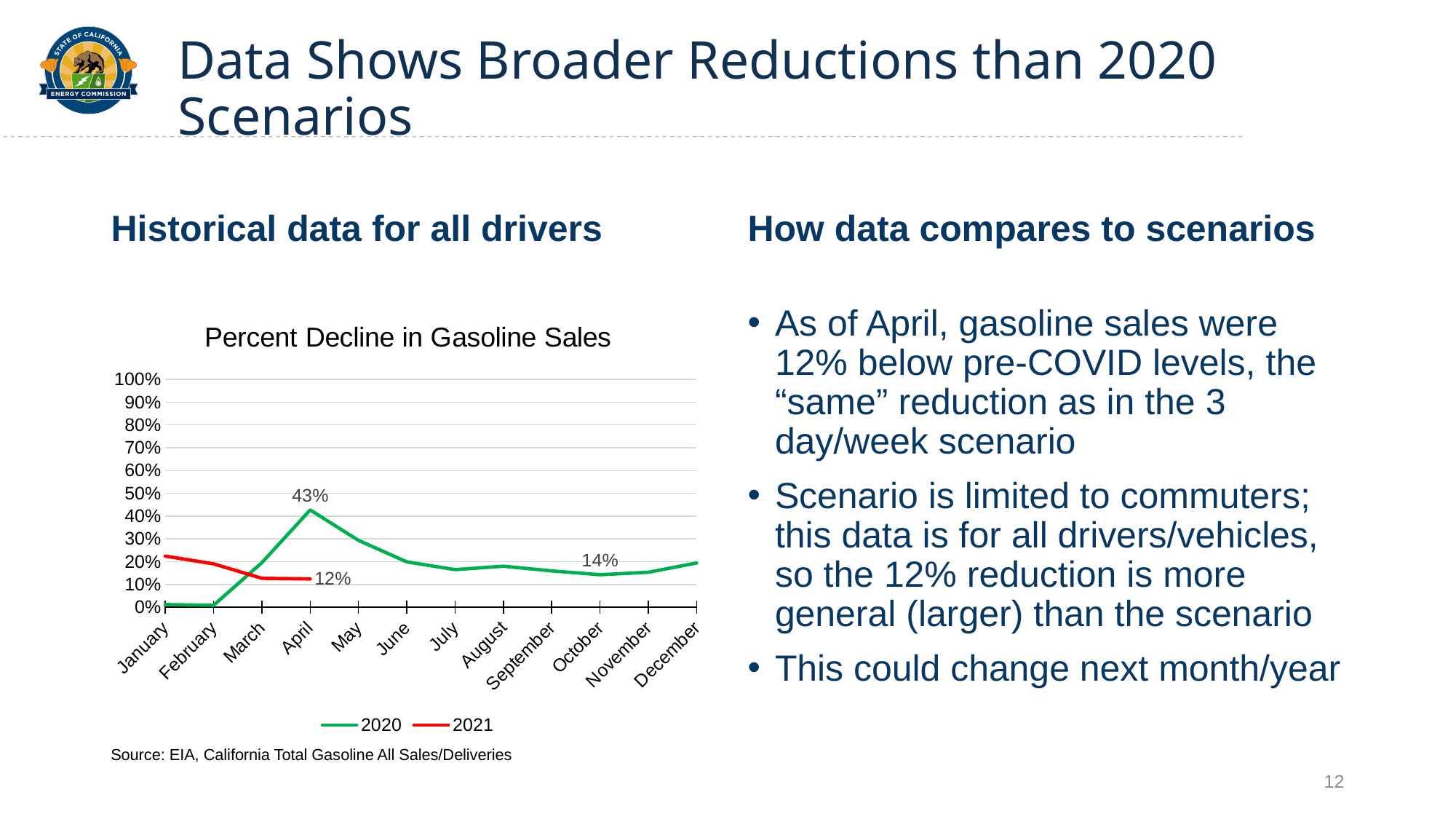
What is the value for the 2020 series in April? 43% What is the difference between the 2020 value in April and the 2021 value in April? 31 percentage points What is the value for the 2020 series in October? 14% Which is larger in April: the 2020 value or the 2021 value? 2020 Does the 2021 series rise or fall from January to April? Fall In which month does the 2020 series reach its highest value? April How many series does the legend list? 2 What kind of chart is shown on the slide? Line chart What is the title of the chart? Percent Decline in Gasoline Sales How many months are shown on the x axis? 12 What is the value for the 2021 series in April? 12% Is the value for the 2020 series in June greater or less than 30%? less